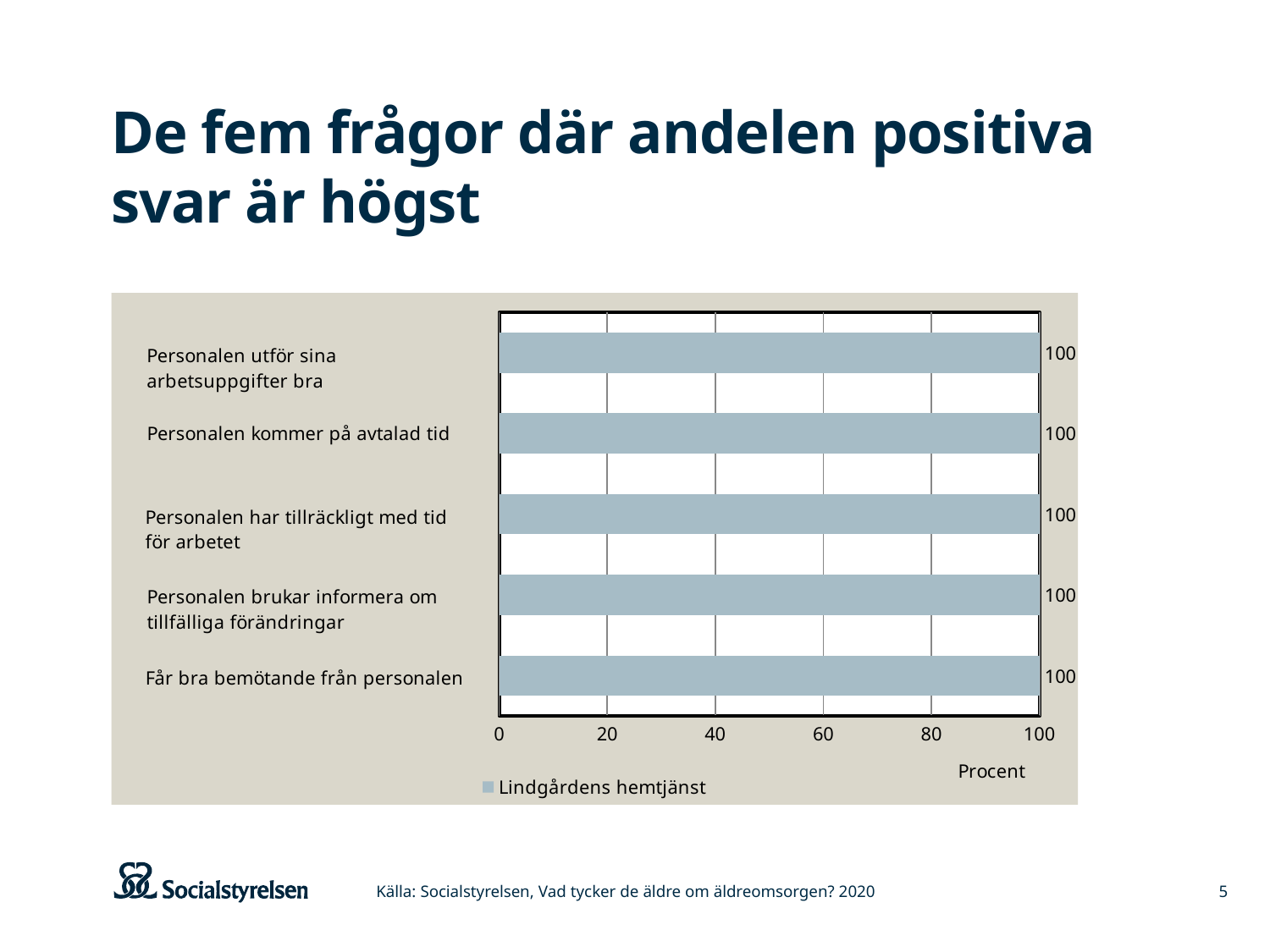
What is the value for "Personalen har tillräckligt med tid för arbetet"? 100 What is the value for "Får bra bemötande från personalen"? 100 How many series does the legend list? 1 What is the difference between the values for "Personalen utför sina arbetsuppgifter bra" and "Får bra bemötande från personalen"? 0 What kind of chart is shown on the slide? bar chart How many categories are shown in the chart? 5 Is the value for "Personalen kommer på avtalad tid" greater or less than 80? greater What unit is labelled on the x axis? Procent What series name is shown in the legend? Lindgårdens hemtjänst What is the value for "Personalen kommer på avtalad tid"? 100 What is the value for "Personalen brukar informera om tillfälliga förändringar"? 100